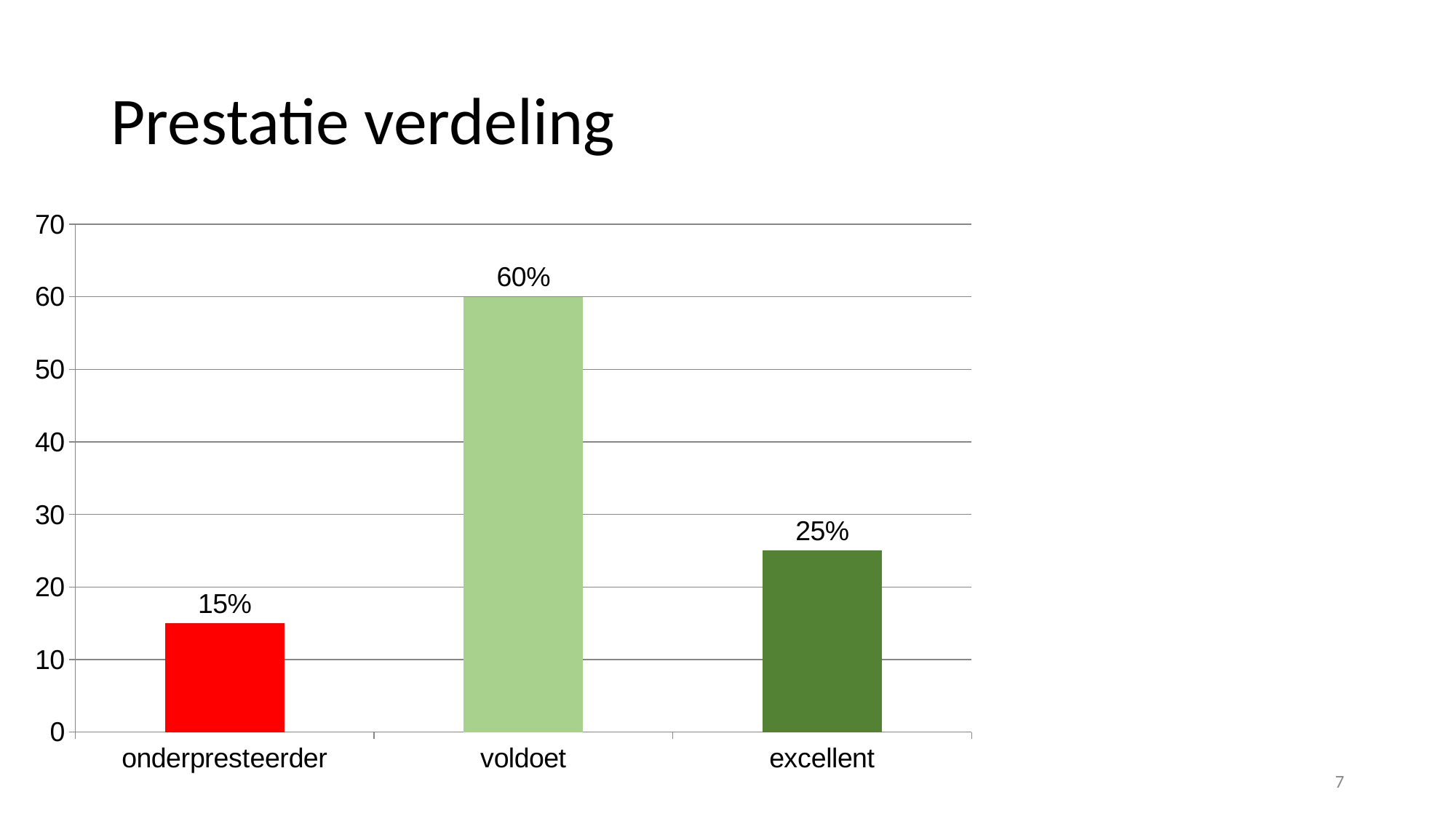
Which is larger, the value for excellent or the value for onderpresteerder? excellent What is the difference between the values for voldoet and excellent? 35% How many categories are shown on the x axis? 3 What is the difference between the values for excellent and onderpresteerder? 10% What kind of chart is shown on the slide? bar chart Is the value for voldoet greater or less than 50? greater What is the value for excellent? 25% What is the value for onderpresteerder? 15% Which category has the highest value? voldoet What is the value for voldoet? 60% Which category has the lowest value? onderpresteerder What is the title of the slide? Prestatie verdeling